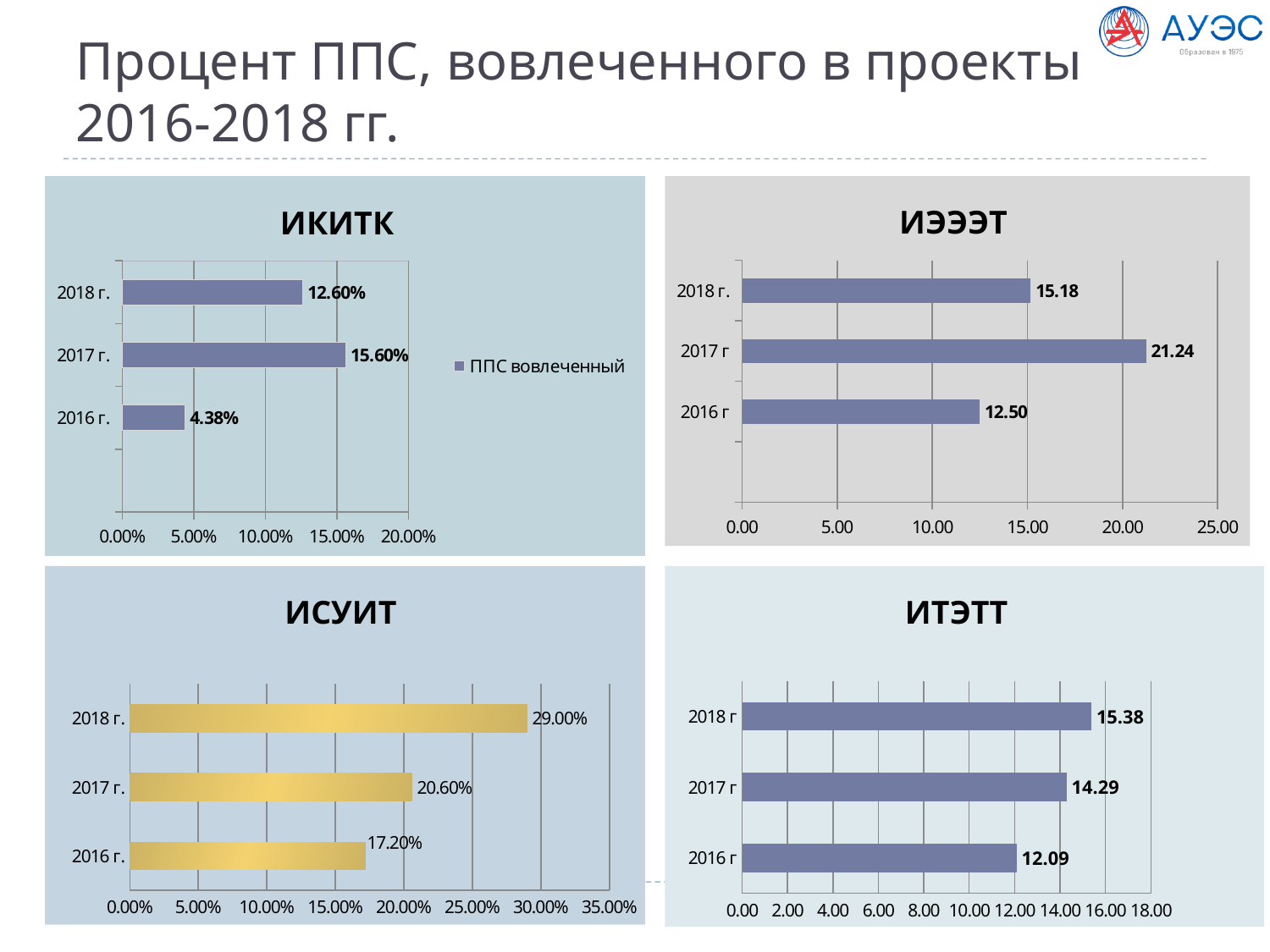
In the ИТЭТТ chart, what is the value for 2016 г? 12.09 In the ИКИТК chart, which year has the lowest value? 2016 г. In the ИТЭТТ chart, which is larger, the value for 2018 г or the value for 2017 г? 2018 г What kind of chart is the ИКИТК chart? bar chart In the ИЭЭЭТ chart, what is the difference between the 2017 г and 2016 г values? 8.74 In the ИЭЭЭТ chart, which year has the highest value? 2017 г What is the legend entry shown next to the ИКИТК chart? ППС вовлеченный In the ИСУИТ chart, what is the difference between the 2018 г. and 2016 г. values? 11.80% In the ИСУИТ chart, do the values rise or fall from 2016 г. to 2018 г.? rise In the ИКИТК chart, what is the value for 2017 г.? 15.60% In the ИСУИТ chart, what is the value for 2018 г.? 29.00% In the ИЭЭЭТ chart, what is the value for 2017 г? 21.24